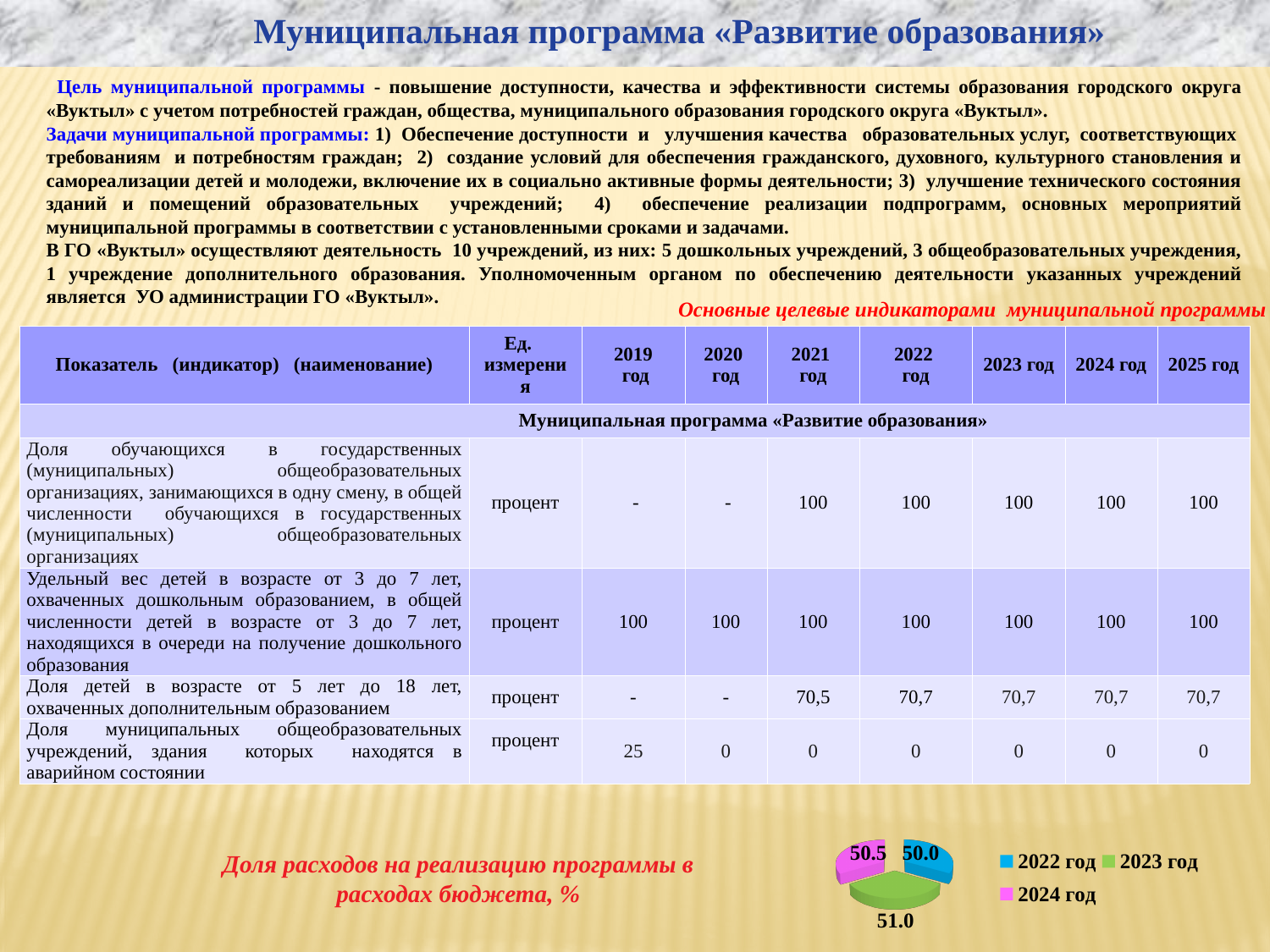
What is the title of the pie chart on the slide? Доля расходов на реализацию программы в расходах бюджета, % What kind of chart is shown at the bottom of the slide? pie chart How many entries does the legend of the pie chart list? 3 In the pie chart, what value is shown for 2024 год? 50.5 How many slices does the pie chart have? 3 In the pie chart, which is larger: the value for 2024 год or the value for 2022 год? 2024 год In the pie chart, what value is shown for 2022 год? 50.0 In the pie chart, what value is shown for 2023 год? 51.0 Which year has the smallest value in the pie chart? 2022 год In the pie chart, what is the difference between the values for 2023 год and 2022 год? 1.0 Which year has the largest value in the pie chart? 2023 год What colour is the slice for 2022 год in the pie chart? blue